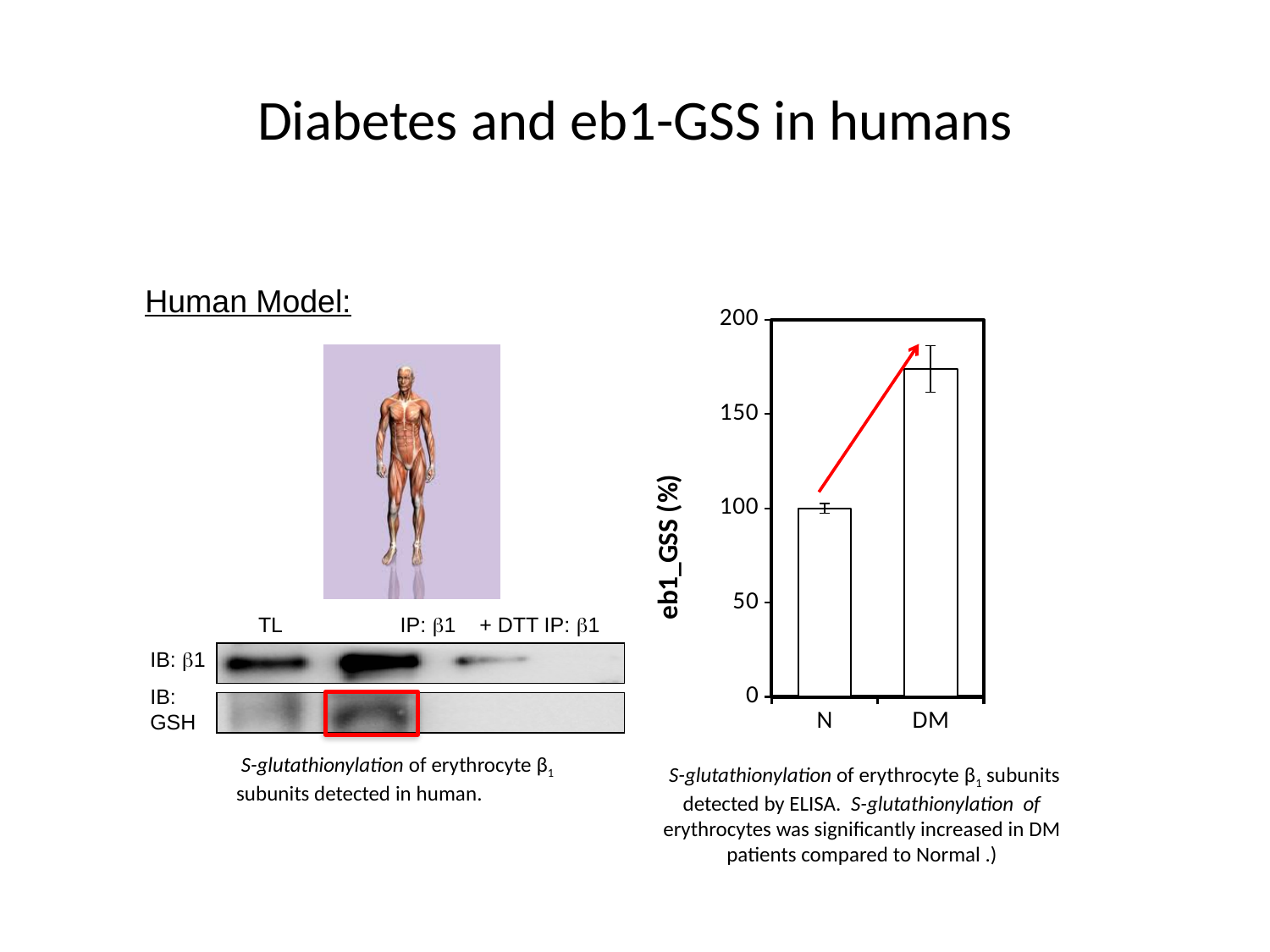
Is the value for N in the bar chart greater or less than 150? less What is the highest tick value shown on the y axis of the bar chart? 200 What is the eb1_GSS (%) value for N in the bar chart? 100 Is the value for DM in the bar chart greater or less than 150? greater Is the value for DM in the bar chart greater or less than 200? less In the bar chart, which is larger, the value for N or the value for DM? DM How many categories are plotted on the x axis of the bar chart? 2 Do the values in the bar chart rise or fall going from N to DM? rise What kind of chart is shown on the right side of the slide? bar chart Which category has the lowest eb1_GSS (%) value in the bar chart? N Which category has the highest eb1_GSS (%) value in the bar chart? DM What is the label of the y axis of the bar chart? eb1_GSS (%)